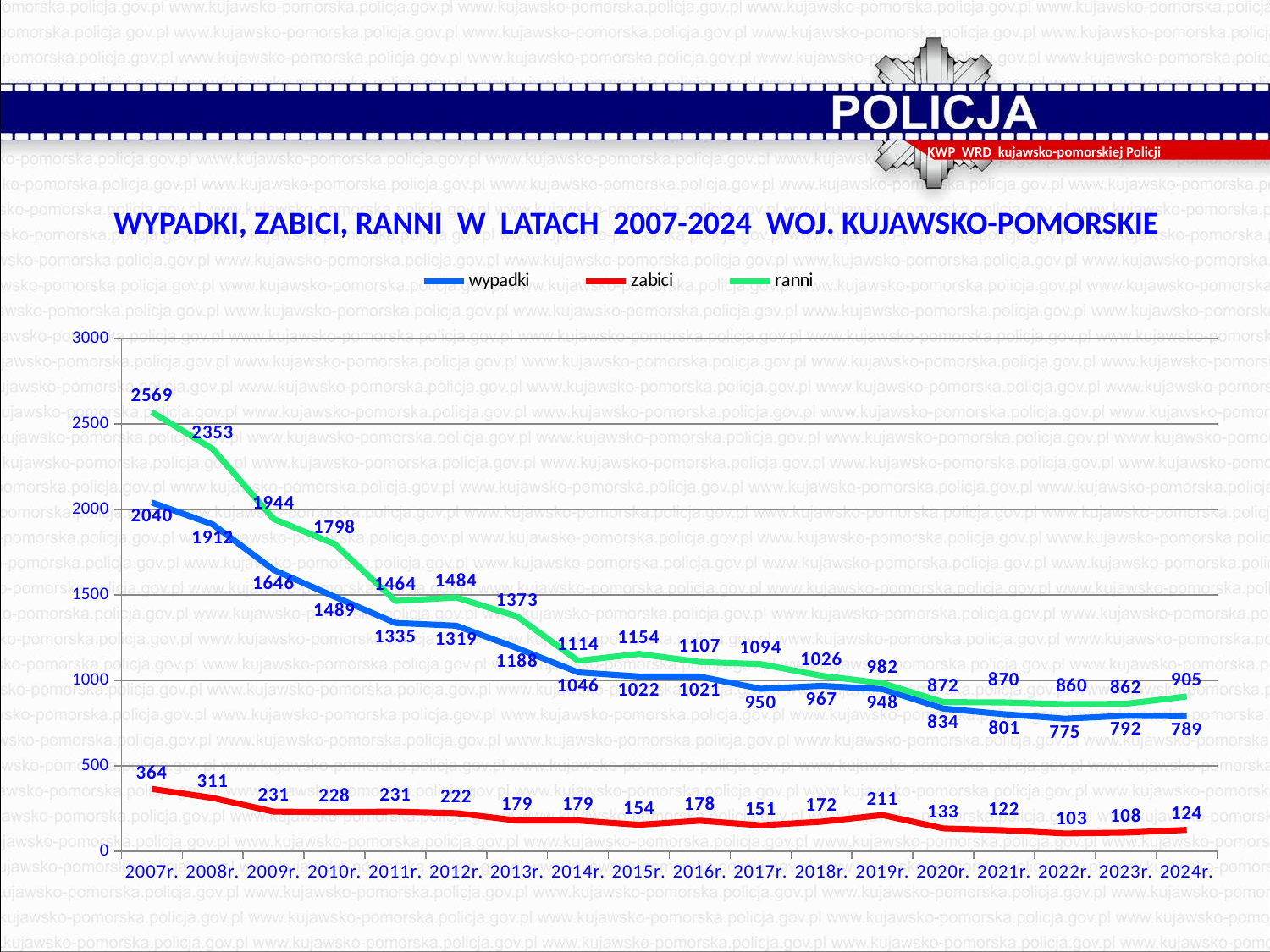
What is the difference between ranni and wypadki in 2012r.? 165 What is the value of zabici in 2019r.? 211 What colour is the line for zabici? red In which year is the wypadki series highest? 2007r. How many series does the legend list? 3 Which is larger in 2018r., wypadki or zabici? wypadki How many years are shown on the x axis? 18 What is the value of wypadki in 2024r.? 789 What is the value of ranni in 2007r.? 2569 In which year is the zabici series lowest? 2022r. Does the ranni series generally rise or fall from 2007r. to 2024r.? fall What kind of chart is shown on the slide? line chart